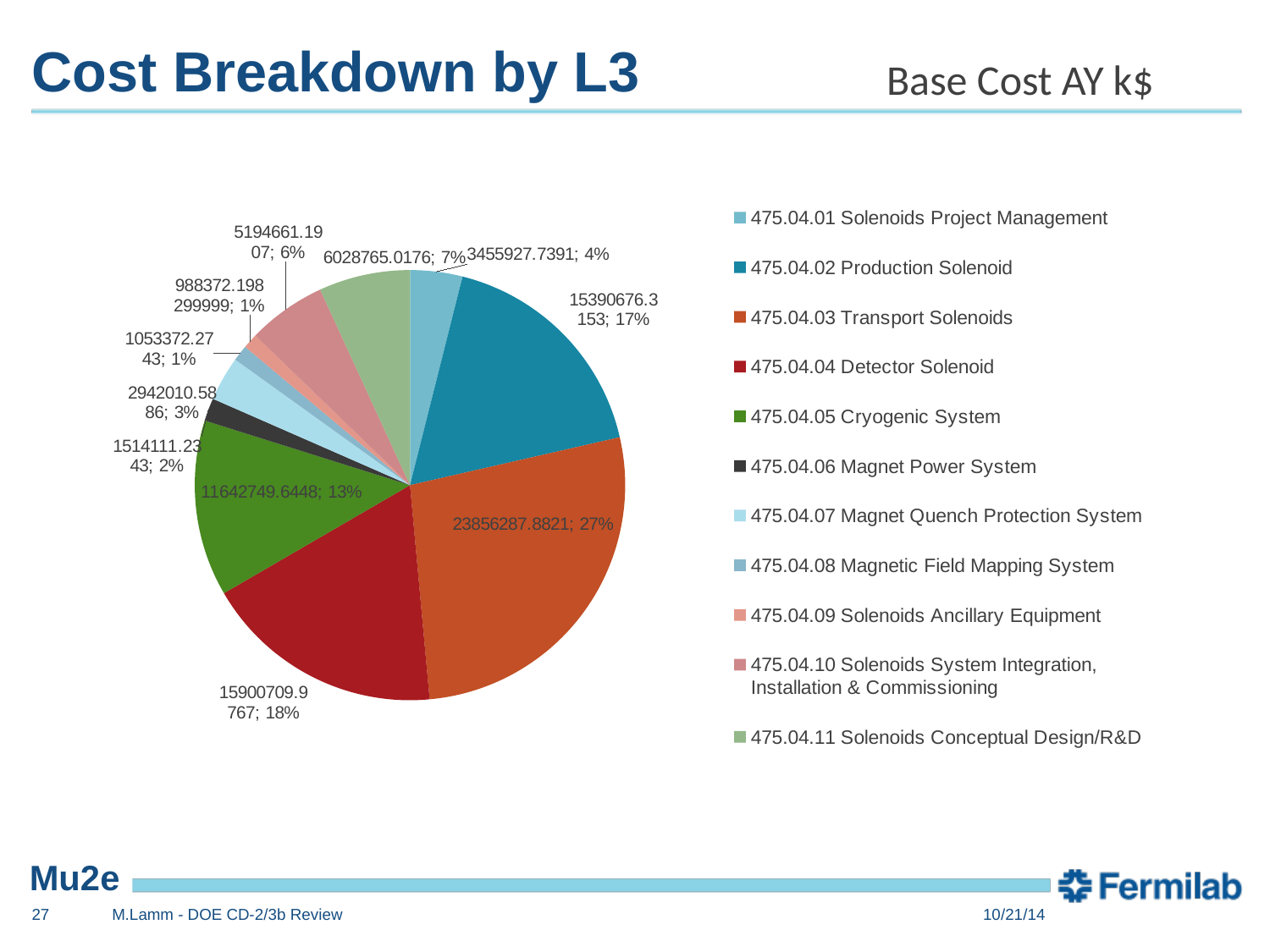
Which L3 item has the largest share of the pie? 475.04.03 Transport Solenoids What kind of chart is shown on the slide? pie chart What is the difference in percentage share between 475.04.03 Transport Solenoids and 475.04.04 Detector Solenoid? 9% What percentage is shown for 475.04.04 Detector Solenoid? 18% Which has the larger share: 475.04.05 Cryogenic System or 475.04.11 Solenoids Conceptual Design/R&D? 475.04.05 Cryogenic System What is the title of the slide containing the chart? Cost Breakdown by L3 What is the base cost value shown for 475.04.03 Transport Solenoids? 23856287.8821 What share of the pie does 475.04.03 Transport Solenoids have? 27% What percentage is shown for 475.04.02 Production Solenoid? 17% What percentage is shown for 475.04.05 Cryogenic System? 13% How many entries does the legend list? 11 How many slices does the pie chart have? 11